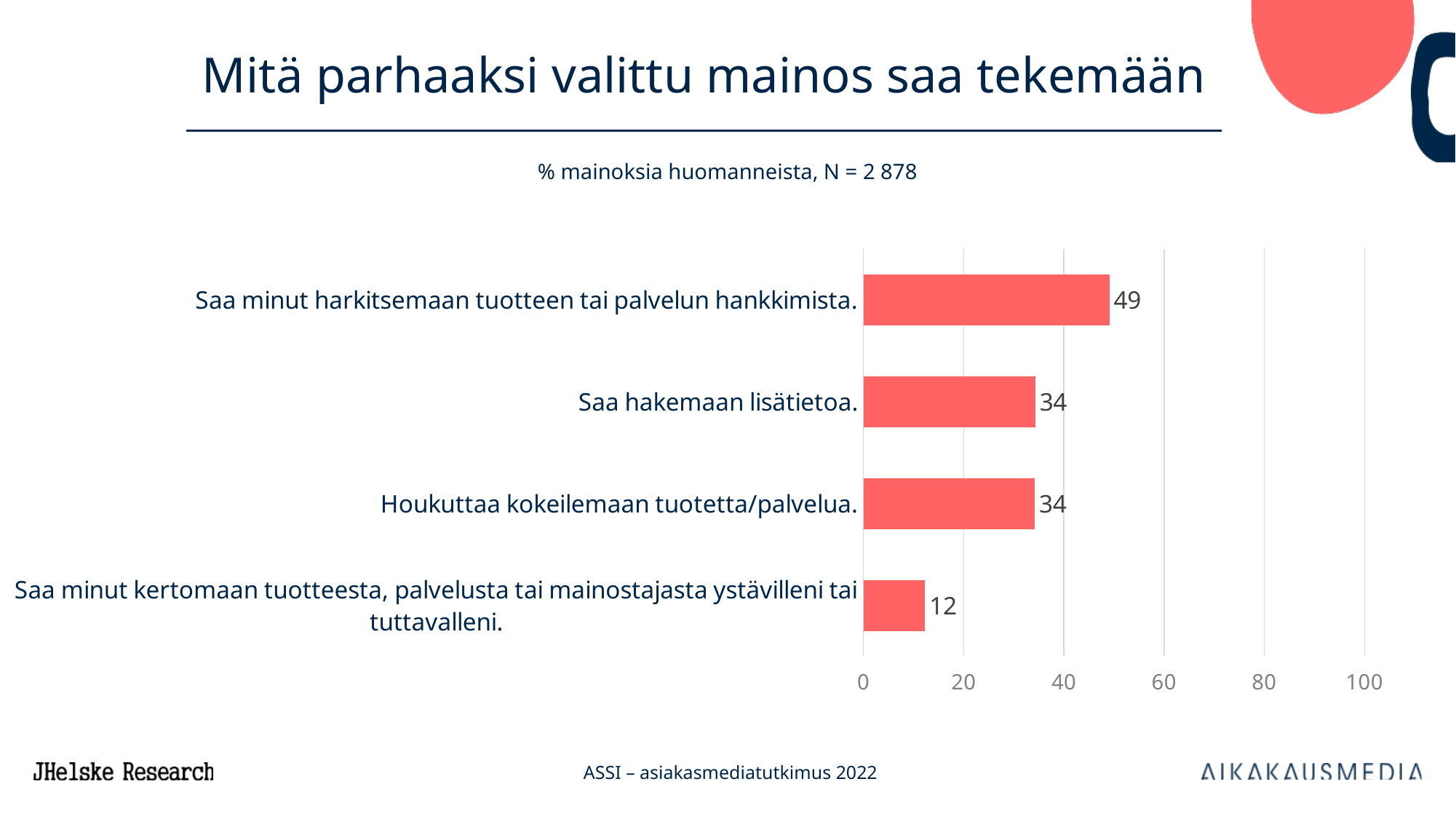
Which category has the highest value? Saa minut harkitsemaan tuotteen tai palvelun hankkimista. What kind of chart is shown on the slide? Bar chart Which category has the lowest value? Saa minut kertomaan tuotteesta, palvelusta tai mainostajasta ystävilleni tai tuttavalleni. What is the difference between the values for "Saa minut harkitsemaan tuotteen tai palvelun hankkimista." and "Saa hakemaan lisätietoa."? 15 What is the difference between the values for "Houkuttaa kokeilemaan tuotetta/palvelua." and "Saa minut kertomaan tuotteesta, palvelusta tai mainostajasta ystävilleni tai tuttavalleni."? 22 What is the value for "Saa minut harkitsemaan tuotteen tai palvelun hankkimista."? 49 How many categories are shown in the chart? 4 What is the value for "Saa minut kertomaan tuotteesta, palvelusta tai mainostajasta ystävilleni tai tuttavalleni."? 12 What is the value for "Saa hakemaan lisätietoa."? 34 Is the value for "Saa minut harkitsemaan tuotteen tai palvelun hankkimista." greater or less than 40? greater What is the title of the chart on the slide? Mitä parhaaksi valittu mainos saa tekemään Which is larger: the value for "Saa hakemaan lisätietoa." or the value for "Saa minut kertomaan tuotteesta, palvelusta tai mainostajasta ystävilleni tai tuttavalleni."? Saa hakemaan lisätietoa.